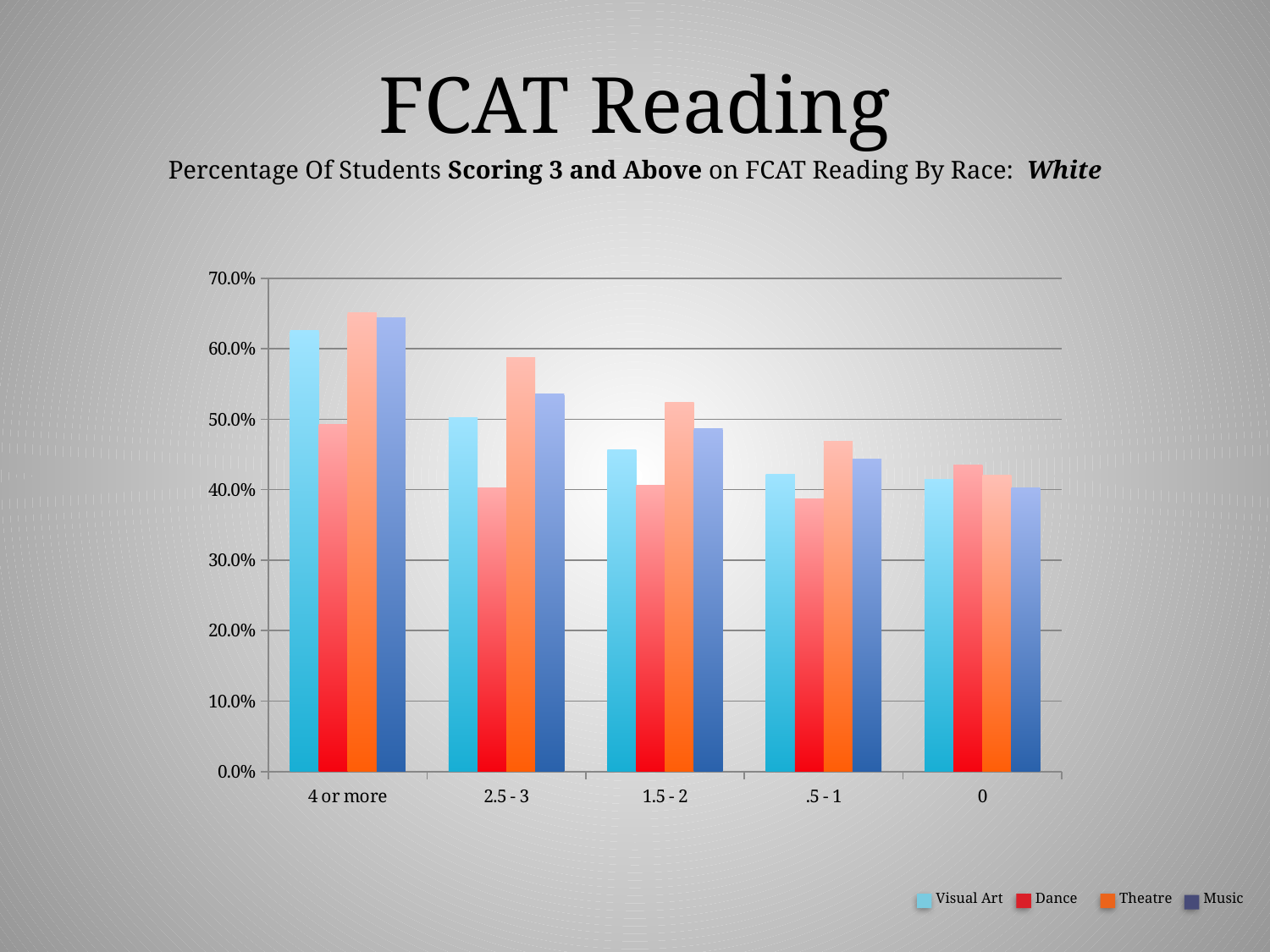
What colour represents the Dance series in the legend? red In the '1.5 - 2' category, which is larger: Theatre or Dance? Theatre What kind of chart is shown on the slide? bar chart Do the Theatre values rise or fall moving from '4 or more' to '0' along the x axis? fall Is the value for Dance in the '2.5 - 3' category greater or less than 50.0%? less Which series has the highest value in the '2.5 - 3' category? Theatre How many series does the legend list? 4 Is the value for Music in the '1.5 - 2' category greater or less than 50.0%? less How many categories are shown on the x axis? 5 Is the value for Theatre in the '4 or more' category greater or less than 60.0%? greater Which series has the lowest value in the '.5 - 1' category? Dance